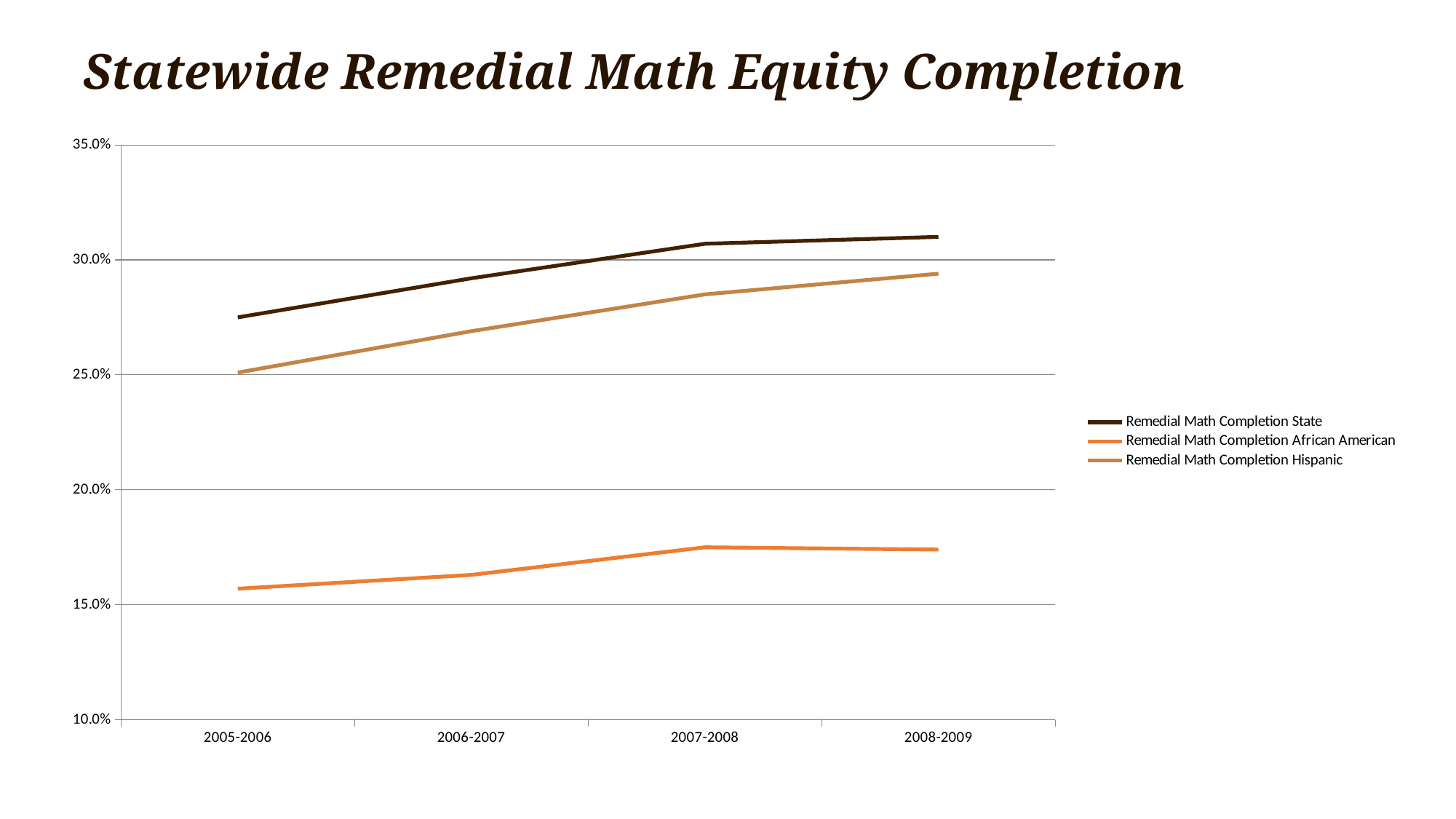
Is the value for Remedial Math Completion Hispanic in 2008-2009 greater or less than 25.0%? greater How many series does the legend list? 3 Is the value for Remedial Math Completion State in 2008-2009 greater or less than 30.0%? greater What is the title of the slide? Statewide Remedial Math Equity Completion How many academic years are plotted along the x axis? 4 What kind of chart is shown on the slide? Line chart Which series has the lowest values across all years? Remedial Math Completion African American In 2005-2006, which is larger: Remedial Math Completion State or Remedial Math Completion Hispanic? Remedial Math Completion State Does the Remedial Math Completion Hispanic line rise or fall from 2005-2006 to 2008-2009? Rises Is the value for Remedial Math Completion African American in 2005-2006 greater or less than 20.0%? less Does the Remedial Math Completion State line rise or fall from 2005-2006 to 2008-2009? Rises Which series has the highest values across all years? Remedial Math Completion State